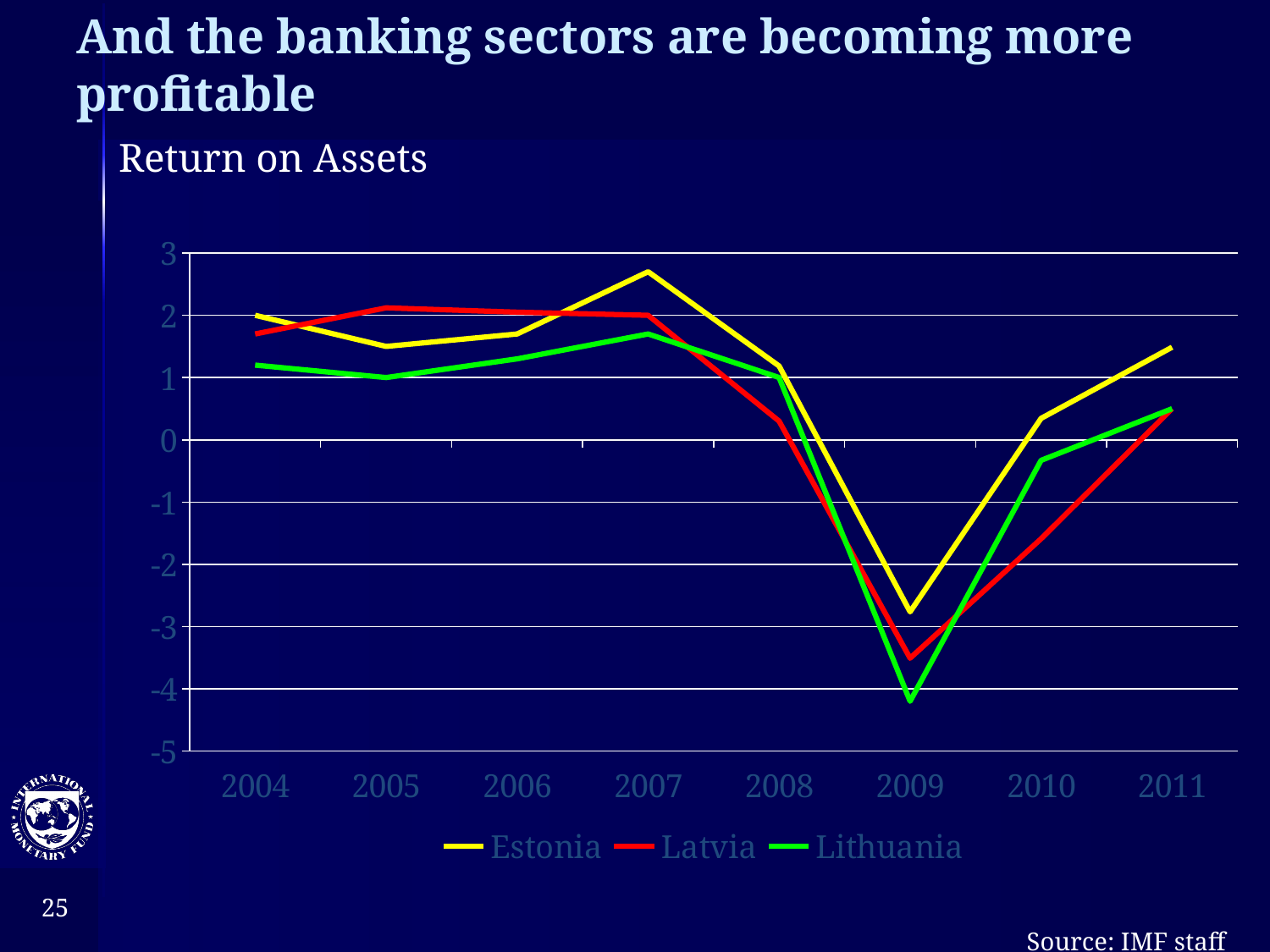
What is the title of the chart? Return on Assets Is the value for Lithuania in 2009 greater or less than -4? less In 2010, which is higher, Estonia or Latvia? Estonia Does Estonia's return on assets rise or fall from 2009 to 2011? rise Is the value for Estonia in 2007 greater or less than 2? greater How many years are plotted along the x axis? 8 In which year does Lithuania reach its lowest return on assets? 2009 What kind of chart is shown on the slide? line chart How many series does the legend list? 3 Which country had the lowest return on assets in 2009? Lithuania In which year does Estonia reach its highest return on assets? 2007 Is the value for Latvia in 2010 greater or less than -1? less